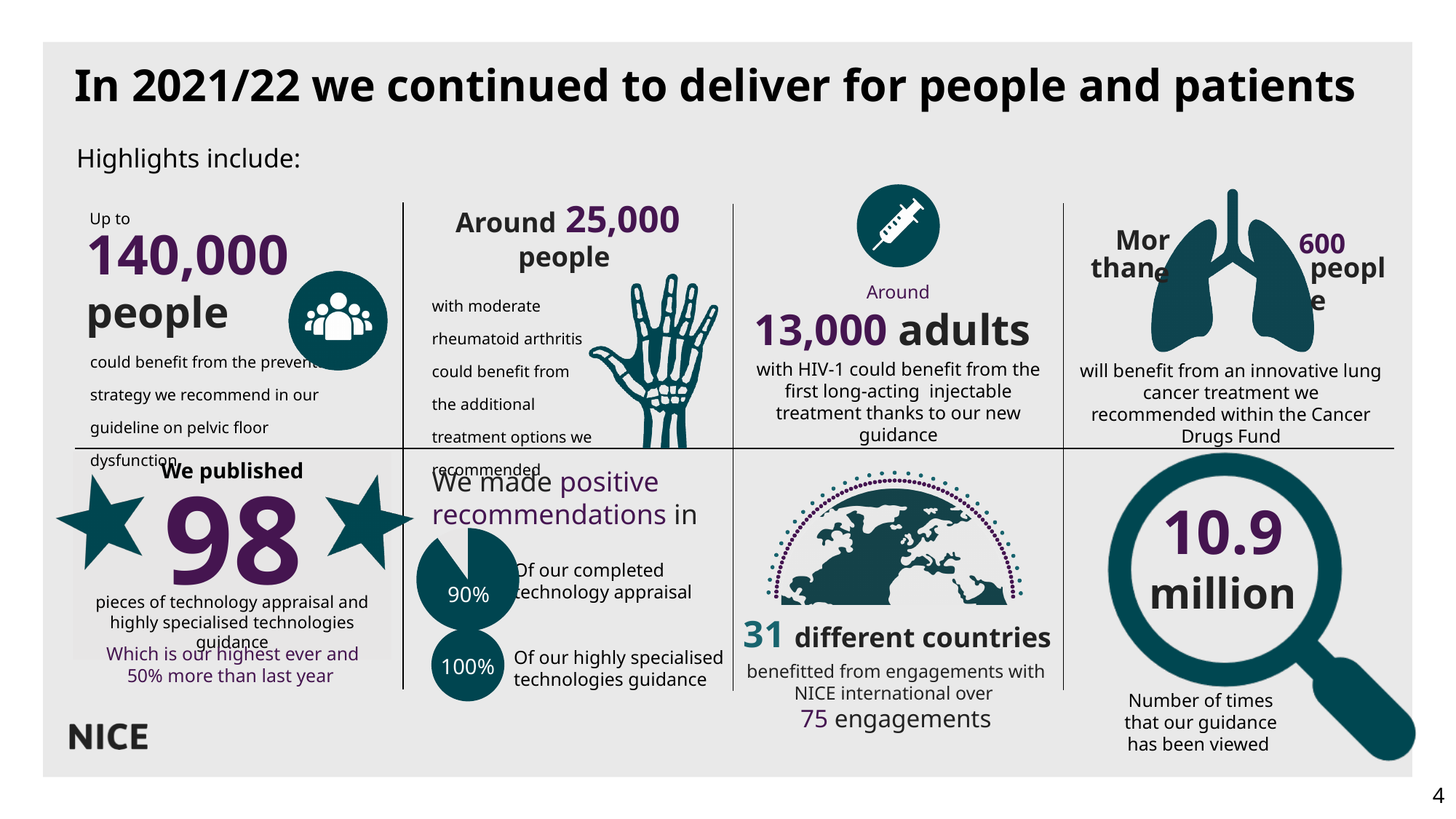
What kind of chart is used to show the share of positive recommendations in completed technology appraisals? pie chart In the pie chart for completed technology appraisal, what percentage received positive recommendations? 90% Is the positive recommendation share for completed technology appraisal greater or less than 50%? greater In the pie chart for highly specialised technologies guidance, what percentage received positive recommendations? 100% Which has the higher share of positive recommendations: completed technology appraisal or highly specialised technologies guidance? highly specialised technologies guidance What is the difference in percentage points between the positive recommendation share for highly specialised technologies guidance and for completed technology appraisal? 10 percentage points In the pie chart for completed technology appraisal, what share of the pie is not covered by the 90% positive recommendations slice? 10%